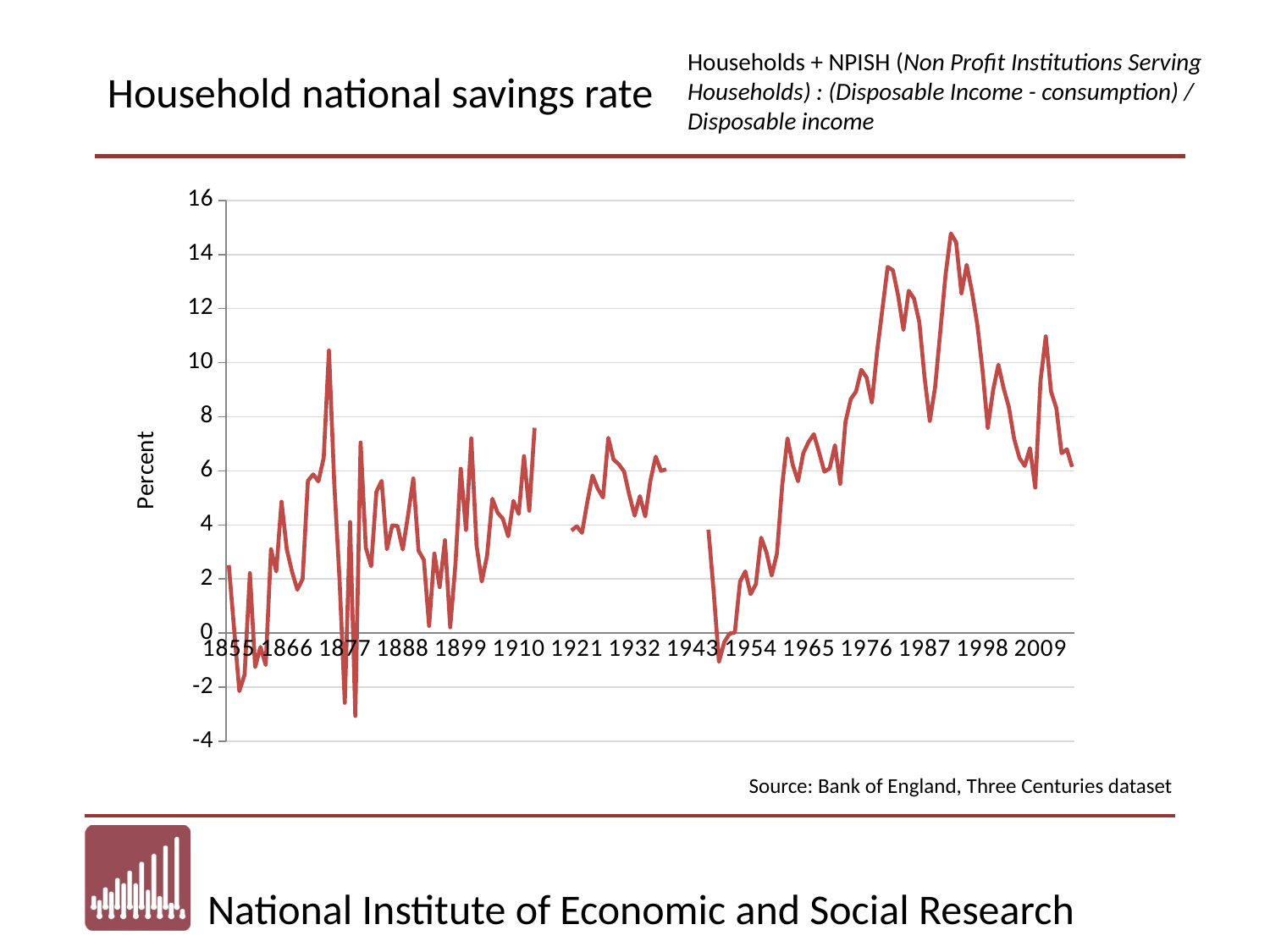
Is the lowest value reached by the line (around 1880) greater or less than -2? less What is the title of the chart? Household national savings rate Is the value of the savings rate around 1976 greater or less than 6? greater Is the savings rate around 1976 higher or lower than around 1921? higher What kind of chart is shown on the slide? line chart Between 1965 and 1987, does the savings rate generally rise or fall? rise Is the value of the savings rate around 1921 greater or less than 6? less How many data series are plotted on the chart? 1 What label is shown on the vertical axis of the chart? Percent